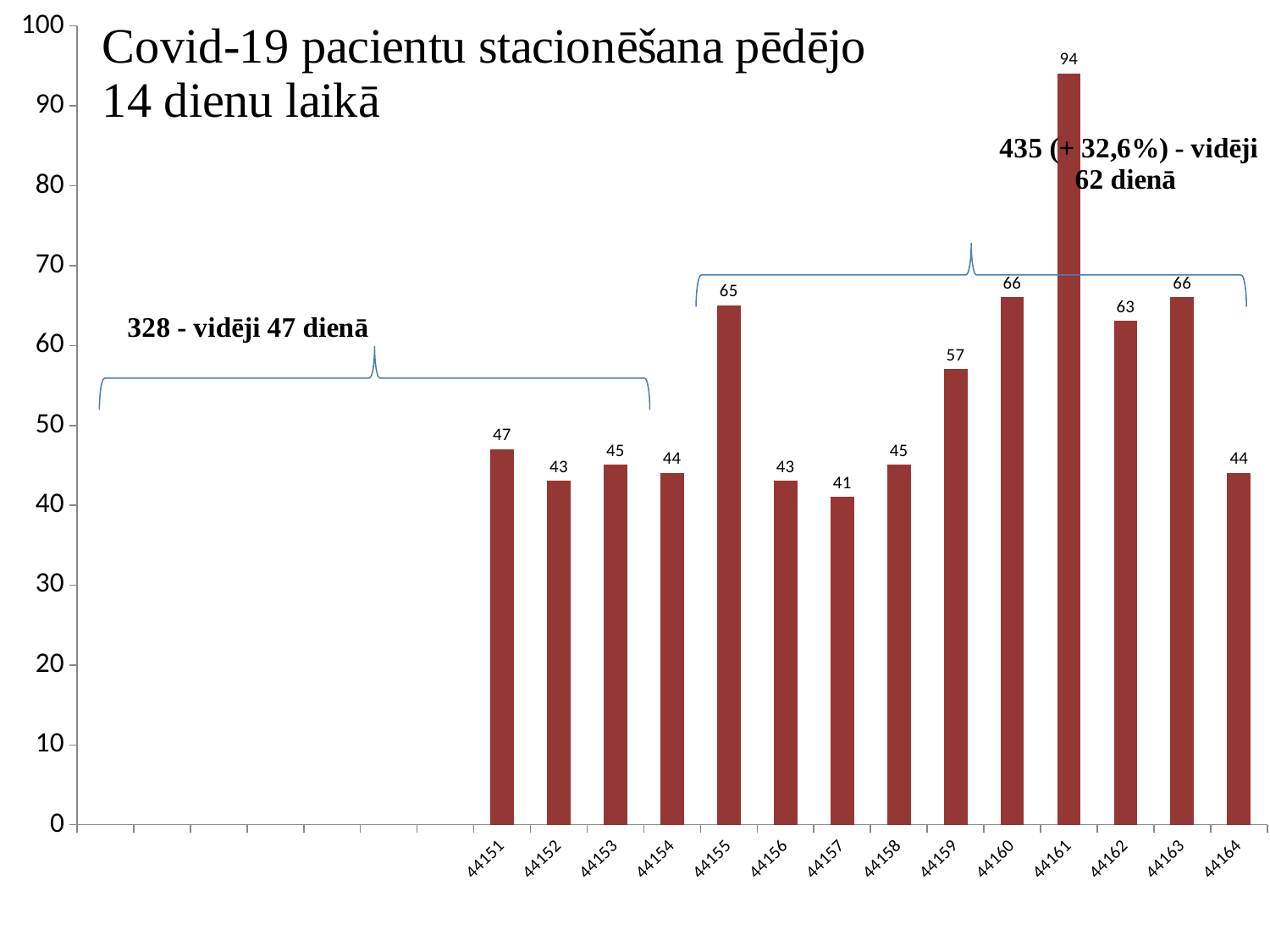
What is the value for category 44155? 65 What type of chart is shown on the slide? bar chart What is the difference between the values for 44161 and 44160? 28 Which category has the highest value? 44161 What is the value for category 44159? 57 What is the difference between the values for 44151 and 44157? 6 Which is larger, the value for 44162 or the value for 44163? 44163 How many bars are plotted in the chart? 14 What is the value for category 44161? 94 Which category has the lowest value? 44157 What is the title of the chart? Covid-19 pacientu stacionēšana pēdējo 14 dienu laikā What does the annotation above the first group of bars say? 328 - vidēji 47 dienā